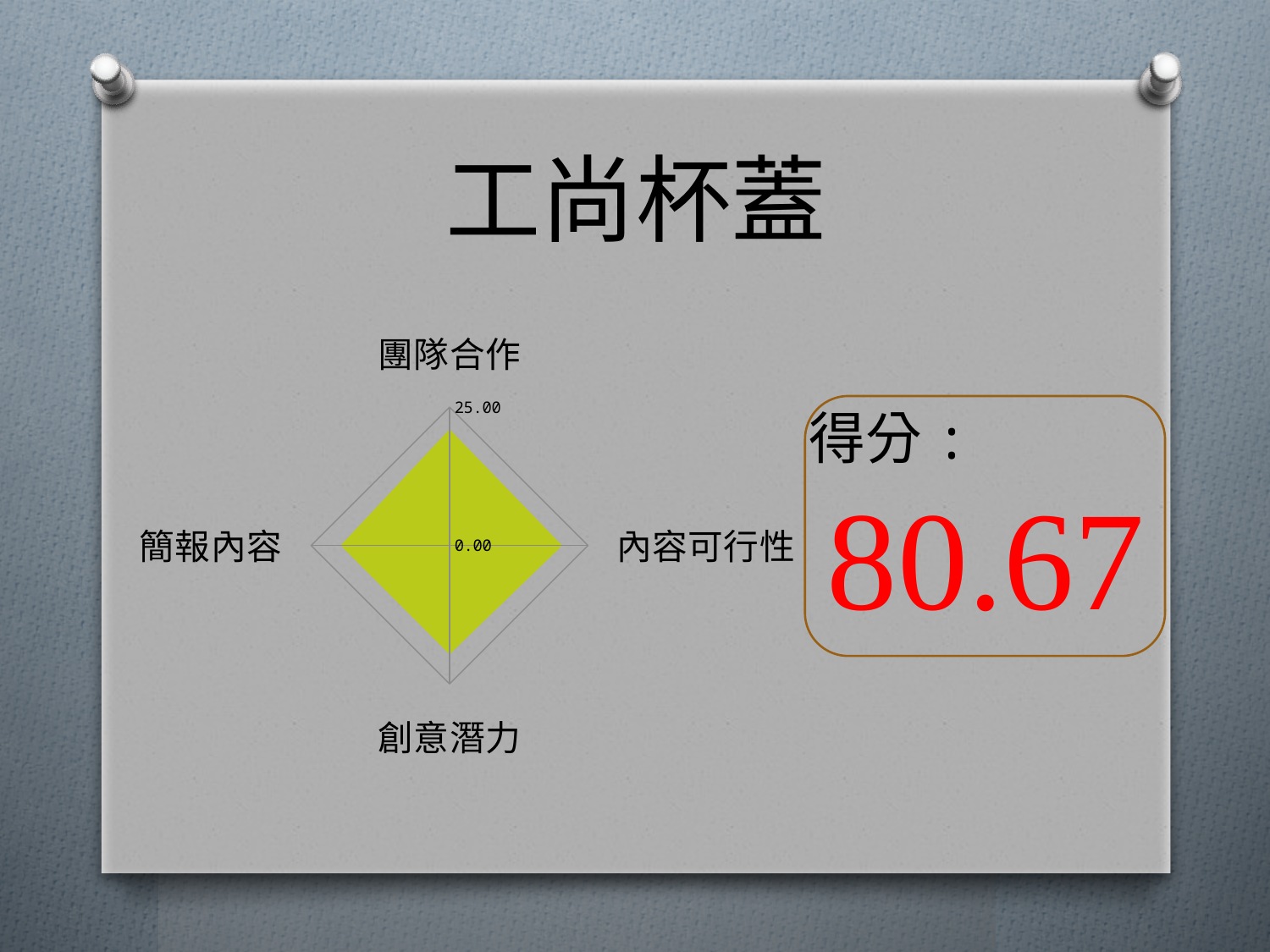
Is the value for 內容可行性 greater or less than 25.00? less How many categories (axes) does the radar chart have? 4 What is the maximum value shown on the radar chart's axis scale? 25.00 Which category is plotted on the right-hand axis of the radar chart? 內容可行性 Is the value for 簡報內容 greater or less than 25.00? less What value is printed at the centre of the radar chart? 0.00 Which category is plotted on the bottom axis of the radar chart? 創意潛力 Is the value for 創意潛力 greater or less than 25.00? less What kind of chart is shown on the slide? Radar chart Which category label appears at the top of the radar chart? 團隊合作 Which category is plotted on the left-hand axis of the radar chart? 簡報內容